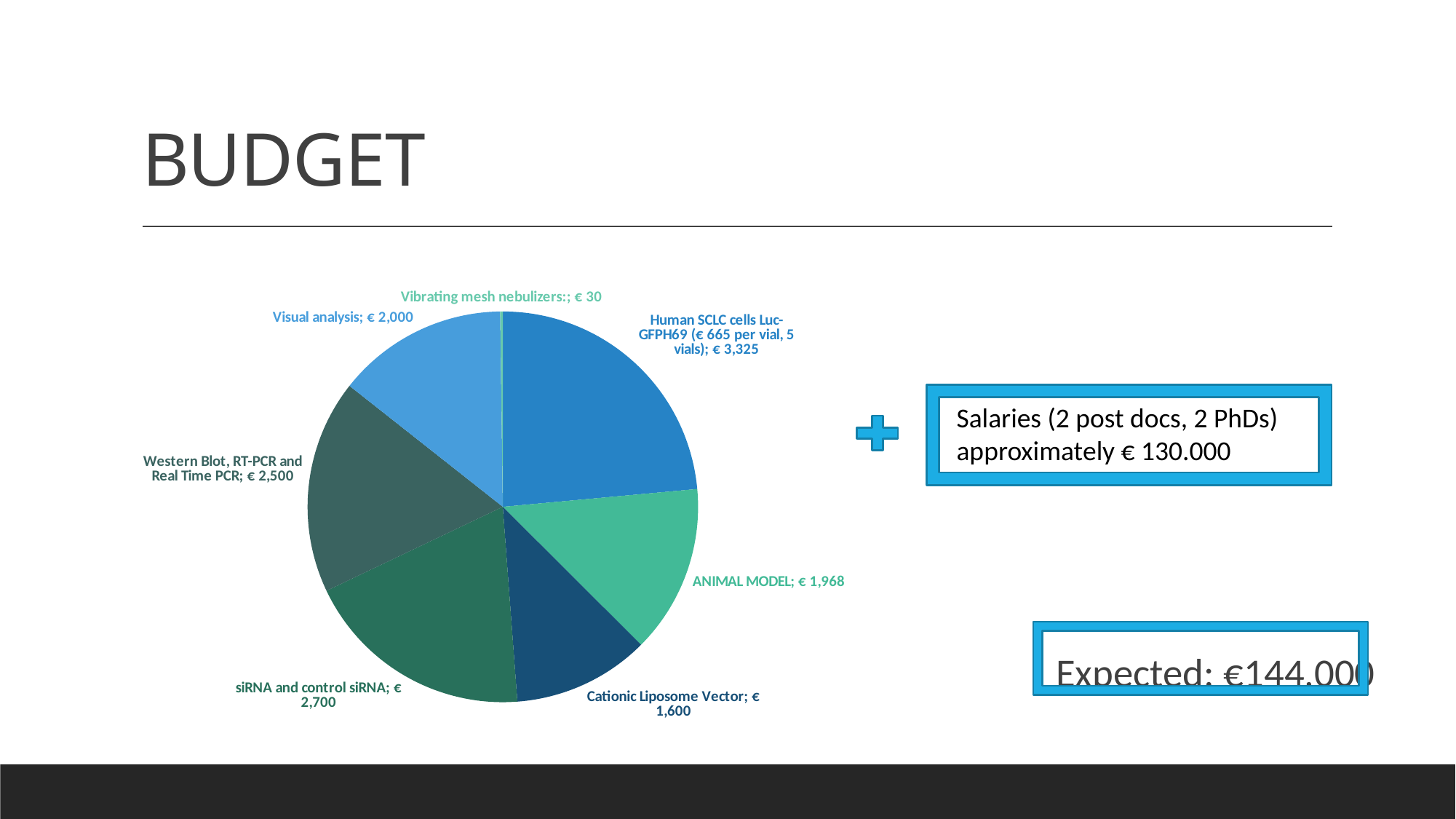
Which is larger: the value for siRNA and control siRNA or the value for Visual analysis? siRNA and control siRNA What is the difference between the value for Human SCLC cells Luc-GFPH69 and the value for ANIMAL MODEL? € 1,357 What is the value for Western Blot, RT-PCR and Real Time PCR? € 2,500 What is the value for Vibrating mesh nebulizers? € 30 What is the value for Cationic Liposome Vector? € 1,600 What is the value for ANIMAL MODEL in the pie chart? € 1,968 What is the difference between the value for siRNA and control siRNA and the value for Western Blot, RT-PCR and Real Time PCR? € 200 Which category has the largest slice of the pie chart? Human SCLC cells Luc-GFPH69 Which category has the smallest slice of the pie chart? Vibrating mesh nebulizers What kind of chart is shown on the slide? Pie chart How many slices does the pie chart have? 7 What is the title of the slide containing the pie chart? BUDGET